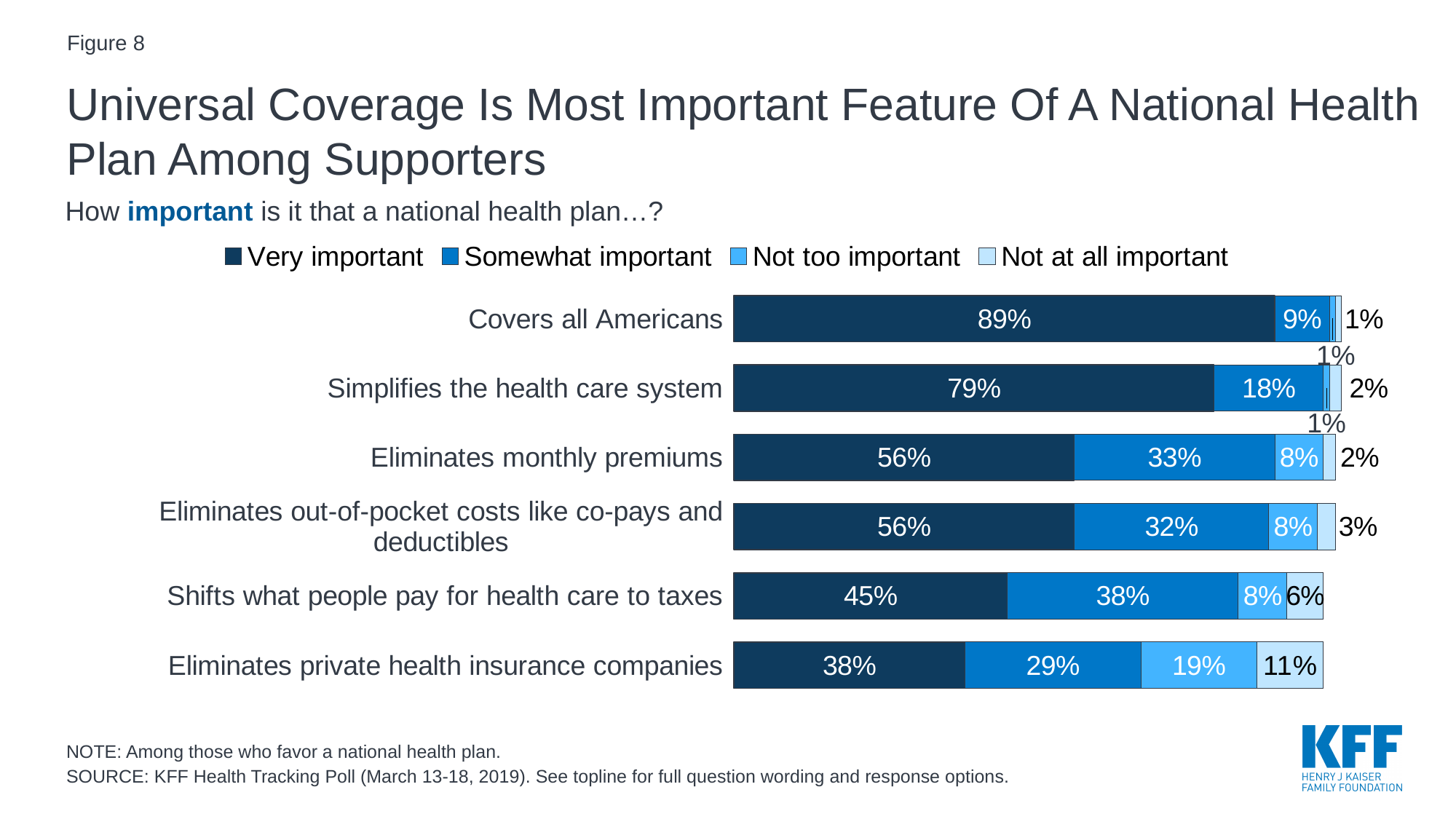
Which feature has the lowest share saying it is very important? Eliminates private health insurance companies How many response categories does the legend list? 4 What type of chart is shown on the slide? Stacked bar chart What percentage say it is not too important that a national health plan eliminates private health insurance companies? 19% What percentage say it is not at all important that a national health plan shifts what people pay for health care to taxes? 6% Which feature has the highest share saying it is very important? Covers all Americans What is the difference between the very important shares for 'Covers all Americans' and 'Simplifies the health care system'? 10 percentage points How many features are listed in the chart? 6 What percentage say it is very important that a national health plan covers all Americans? 89% Which response category is shown in the darkest blue? Very important Which has a larger somewhat important share: 'Shifts what people pay for health care to taxes' or 'Eliminates monthly premiums'? Shifts what people pay for health care to taxes What percentage say it is somewhat important that a national health plan simplifies the health care system? 18%